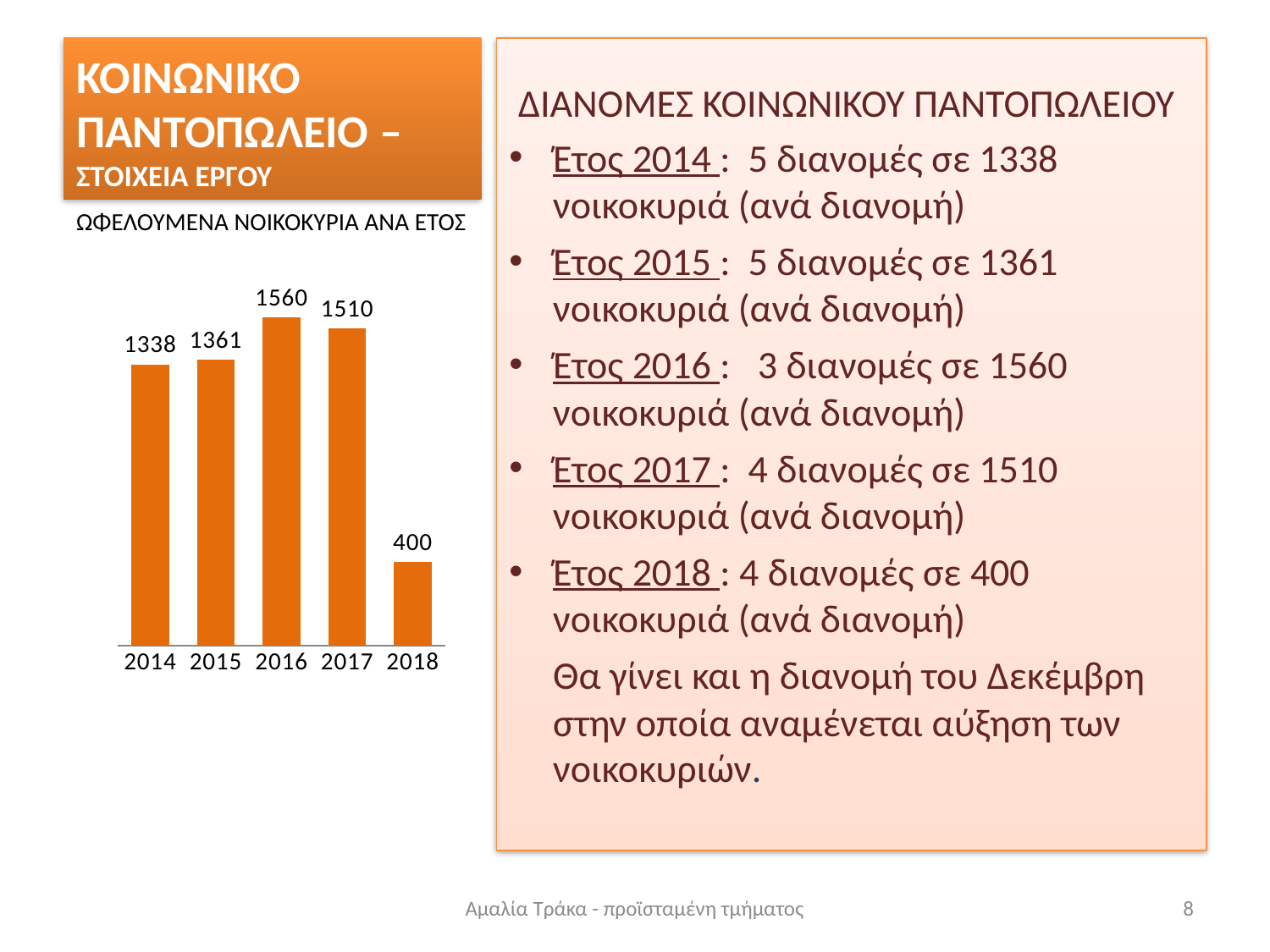
What is the value for 2018 in the chart? 400 How many years are shown on the x axis of the chart? 5 What is the value for 2014 in the chart? 1338 What kind of chart is shown on the slide? bar chart What is the difference between the values for 2015 and 2014? 23 Do the values rise or fall from 2017 to 2018? fall What is the title of the chart? ΩΦΕΛΟΥΜΕΝΑ ΝΟΙΚΟΚΥΡΙΑ ΑΝΑ ΕΤΟΣ Which is larger, the value for 2017 or the value for 2015? 2017 What is the difference between the values for 2016 and 2017? 50 Which year has the lowest value in the chart? 2018 What is the value for 2016 in the chart? 1560 Which year has the highest value in the chart? 2016